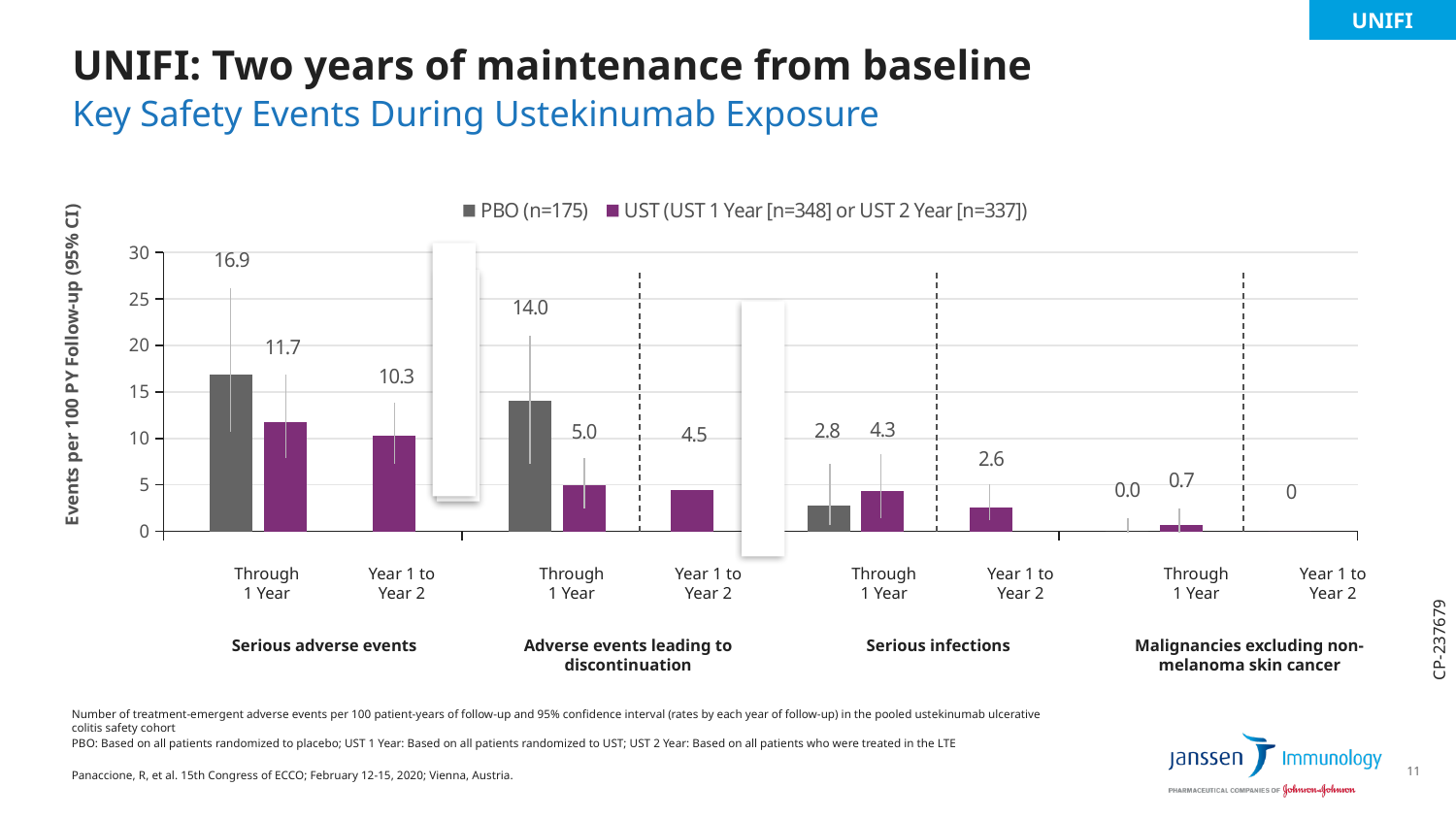
For serious infections through 1 year, which is larger, the PBO value or the UST value? UST (4.3) What is the UST value for adverse events leading to discontinuation through 1 year? 5.0 Which bar has the highest value on the chart? PBO, serious adverse events through 1 year (16.9) What is the UST value for serious infections from Year 1 to Year 2? 2.6 What is the UST value for serious adverse events from Year 1 to Year 2? 10.3 What is the label of the y-axis? Events per 100 PY Follow-up (95% CI) How many series does the legend list? 2 What is the difference between the PBO and UST values for adverse events leading to discontinuation through 1 year? 9.0 What kind of chart is shown on the slide? Bar chart What is the UST value for malignancies excluding non-melanoma skin cancer through 1 year? 0.7 What is the difference between the PBO and UST values for serious adverse events through 1 year? 5.2 What is the PBO value for serious adverse events through 1 year? 16.9